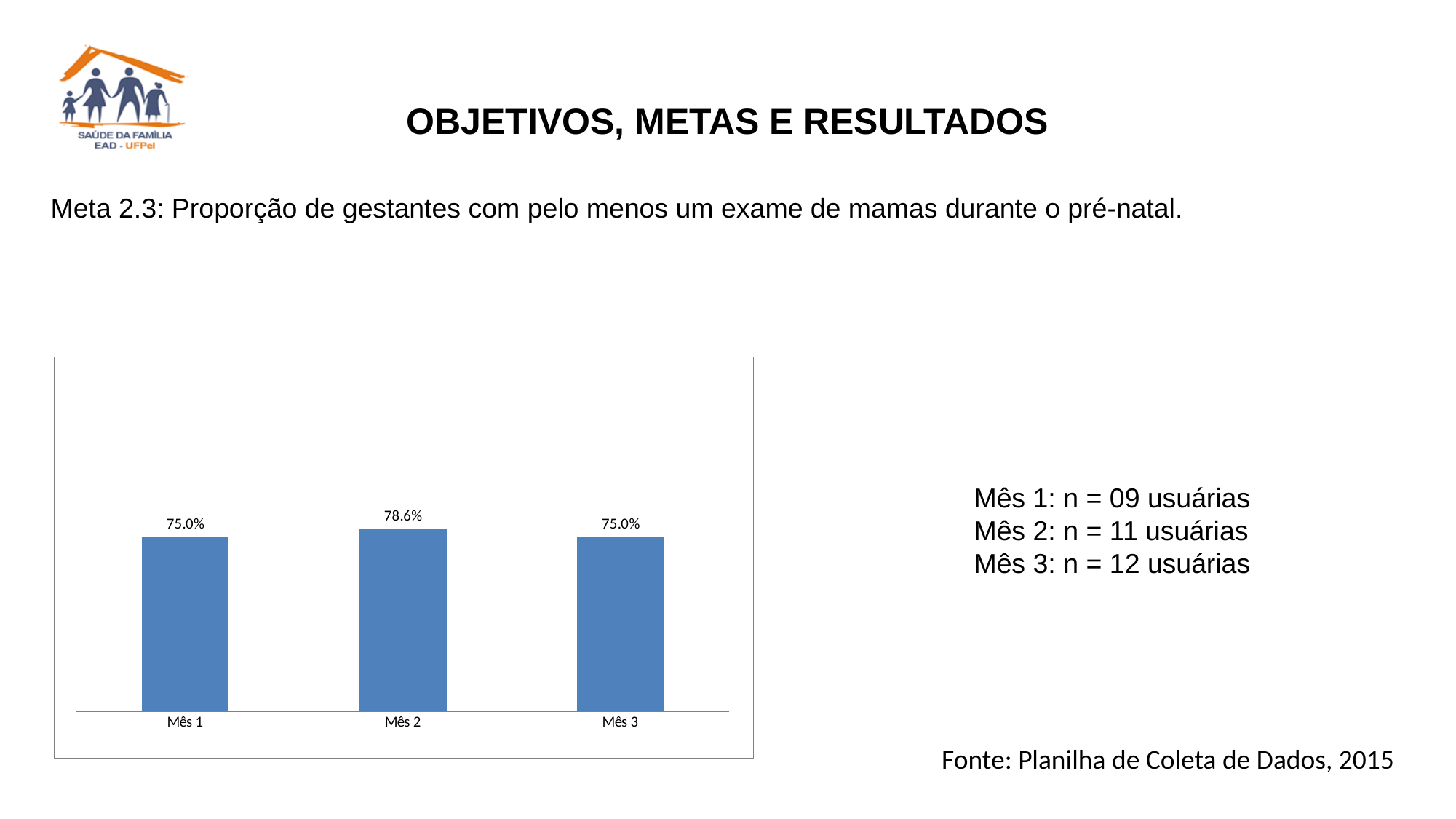
What is the difference between the values for Mês 2 and Mês 1? 3.6% Which month has the highest value? Mês 2 What kind of chart is shown on the slide? Bar chart Which is larger, the value for Mês 2 or the value for Mês 3? Mês 2 What is the value for Mês 2? 78.6% According to the text next to the chart, how many usuárias were there in Mês 3? 12 Do the values for Mês 1 and Mês 3 differ? No, both are 75.0% What colour are the bars in the chart? Blue How many categories are shown on the x axis of the chart? 3 What is the value for Mês 3? 75.0% What is the value for Mês 1? 75.0%